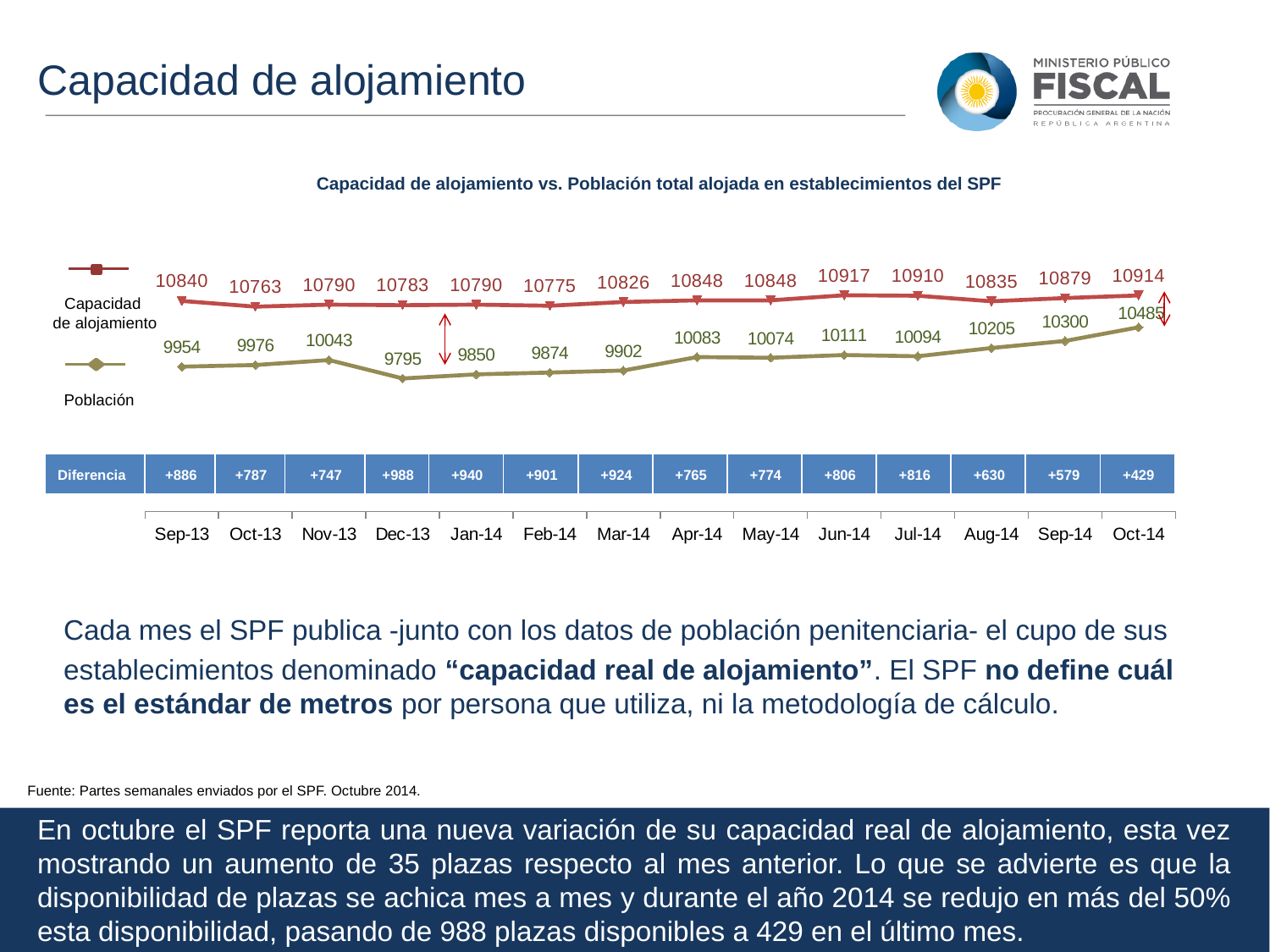
How many series does the legend list? 2 How many months are plotted on the x axis? 14 In which month is Capacidad de alojamiento lowest? Oct-13 In which month is Población lowest? Dec-13 In which month is Capacidad de alojamiento highest? Jun-14 What kind of chart is shown? Line chart Does Población rise or fall overall from Sep-13 to Oct-14? Rise What is the value of Población in Oct-14? 10485 What is the difference between Capacidad de alojamiento and Población in Oct-14? 429 Which is larger in Sep-14, Capacidad de alojamiento or Población? Capacidad de alojamiento What is the value of Población in Dec-13? 9795 What is the value of Capacidad de alojamiento in Sep-13? 10840